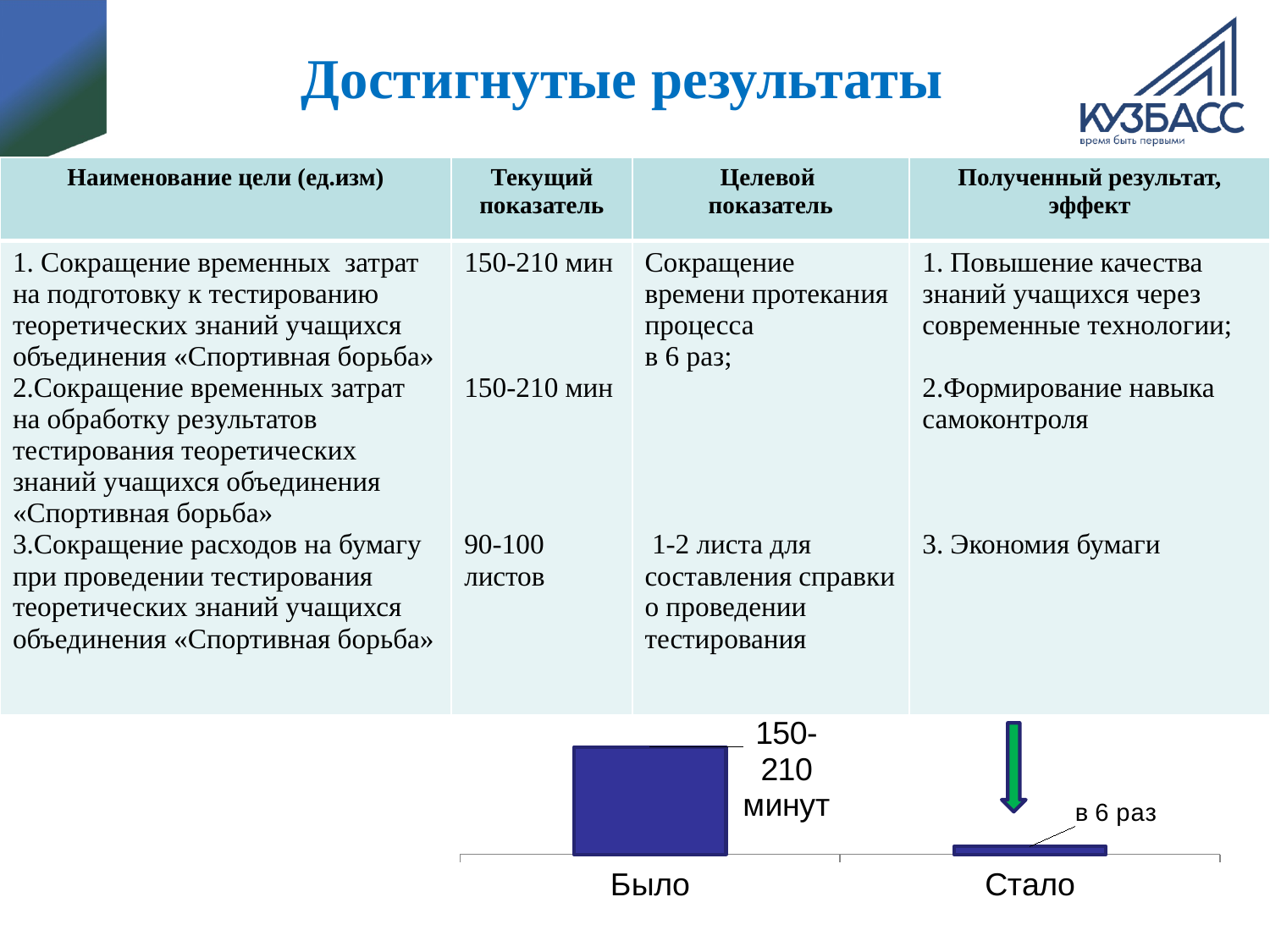
What kind of chart is shown at the bottom of the slide? bar chart Do the bar values rise or fall from Было to Стало? fall In the bar chart, which bar is taller, Было or Стало? Было What label is printed next to the Было bar in the chart? 150-210 минут How many categories does the bar chart at the bottom of the slide show? 2 What colour are the bars in the chart at the bottom of the slide? dark blue Which category in the bar chart has the highest bar? Было What are the two category labels on the x axis of the bar chart? Было, Стало What label is printed next to the Стало bar in the chart? в 6 раз Which category in the bar chart has the lowest bar? Стало